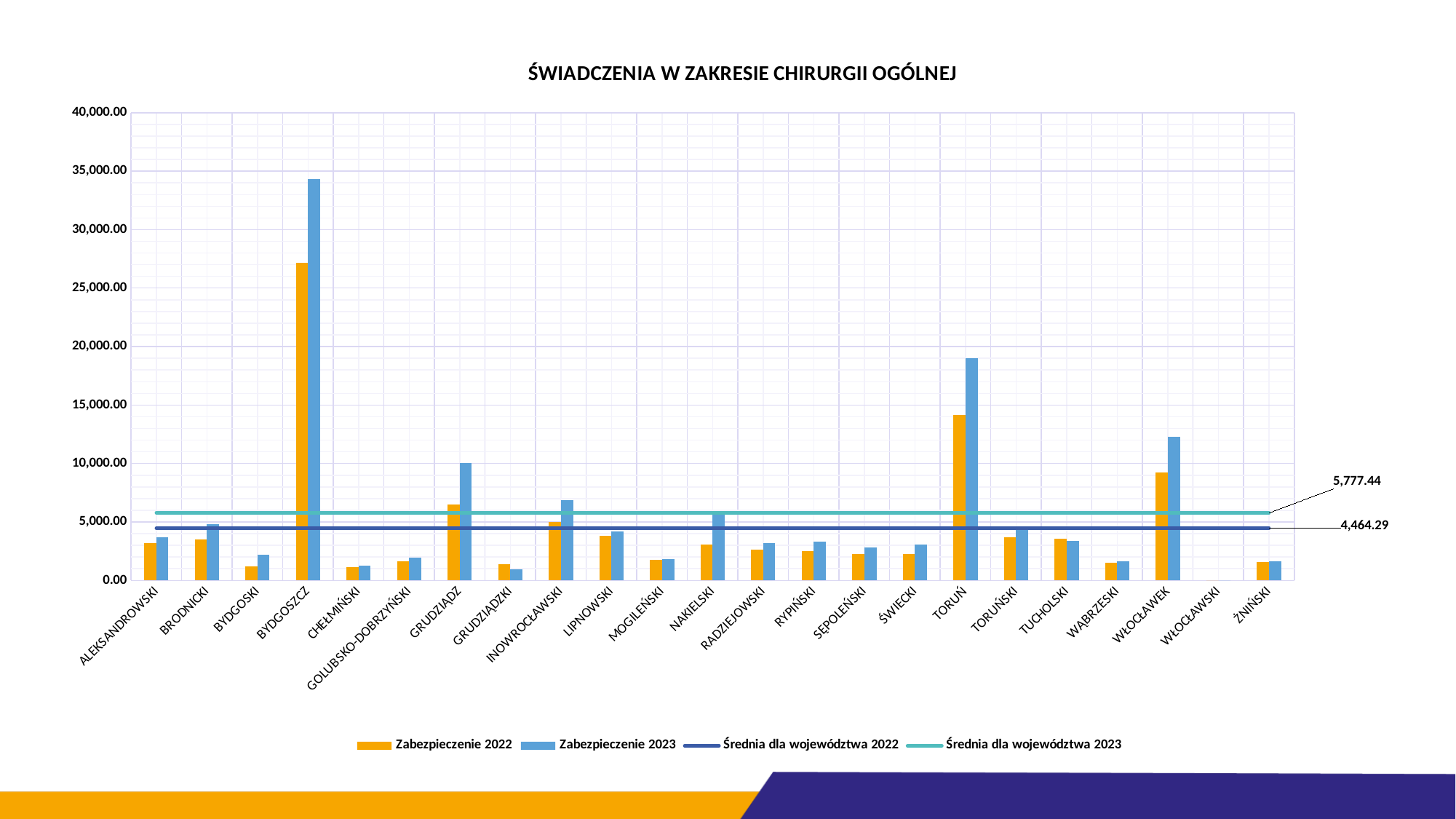
What is the difference between the Średnia dla województwa 2023 and Średnia dla województwa 2022 values? 1,313.15 What is the value of the Średnia dla województwa 2023 line? 5,777.44 What kind of chart is shown on the slide? bar chart What is the value of the Średnia dla województwa 2022 line? 4,464.29 Is the Zabezpieczenie 2022 value for WŁOCŁAWEK greater or less than 10,000.00? less How many categories are shown on the x axis? 23 Is the Zabezpieczenie 2023 value for BYDGOSZCZ greater or less than 30,000.00? greater Which category has the highest Zabezpieczenie 2022 value? BYDGOSZCZ Which is larger, the Zabezpieczenie 2023 value for TORUŃ or for WŁOCŁAWEK? TORUŃ Which category has the highest Zabezpieczenie 2023 value? BYDGOSZCZ What is the title of the chart? ŚWIADCZENIA W ZAKRESIE CHIRURGII OGÓLNEJ How many series does the legend list? 4